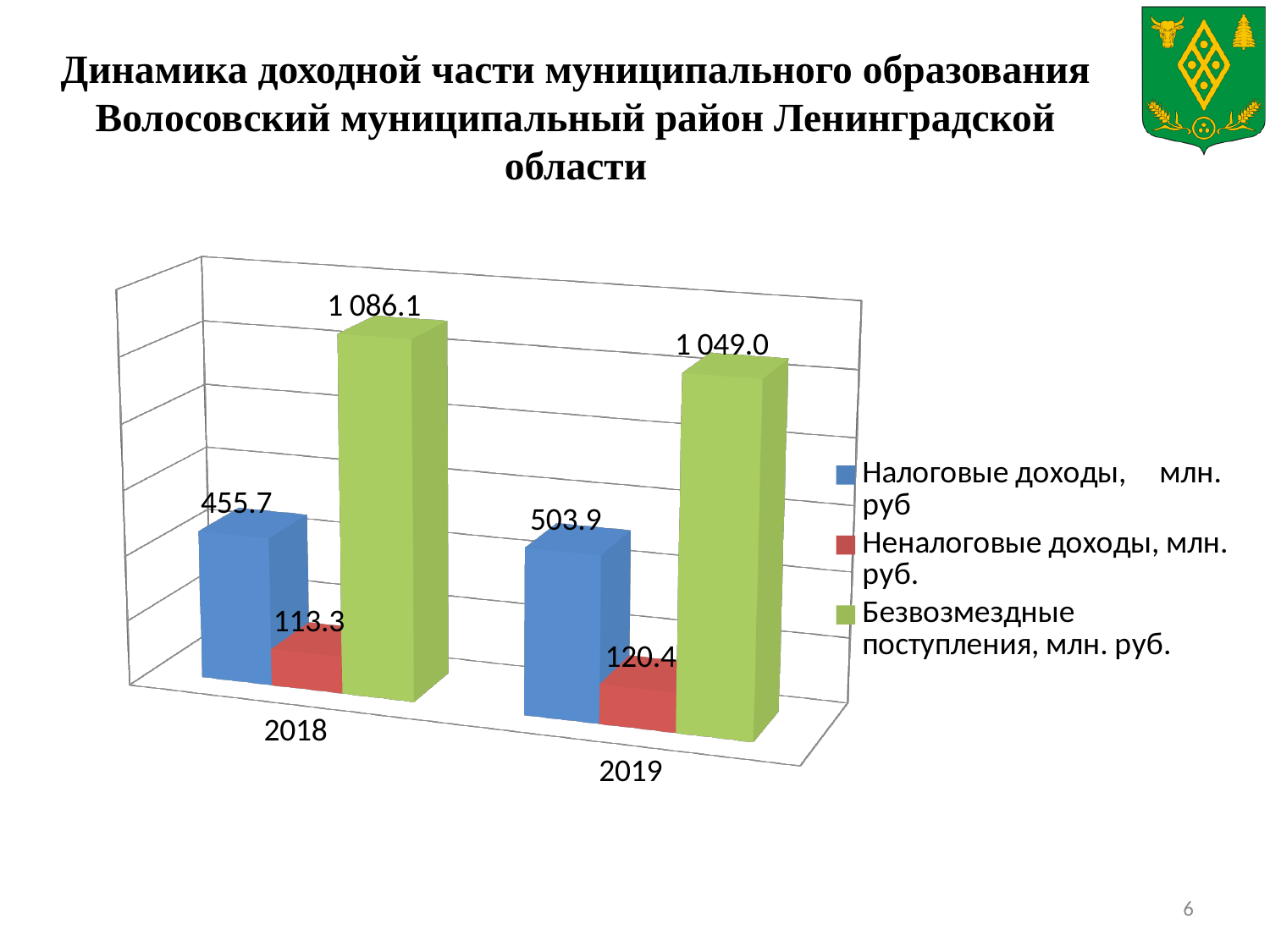
What is the value of Безвозмездные поступления for 2018? 1 086.1 How many years are shown on the x axis? 2 How many series does the legend list? 3 What is the difference between Налоговые доходы in 2019 and in 2018? 48.2 Which year has the larger value for Безвозмездные поступления, 2018 or 2019? 2018 What is the value of Неналоговые доходы for 2019? 120.4 Do the values for Неналоговые доходы rise or fall from 2018 to 2019? Rise Which series has the lowest value in 2018? Неналоговые доходы, млн. руб. What is the value of Безвозмездные поступления for 2019? 1 049.0 What is the value of Налоговые доходы for 2018? 455.7 Which series has the highest value in 2019? Безвозмездные поступления, млн. руб. What kind of chart is shown on the slide? Bar chart